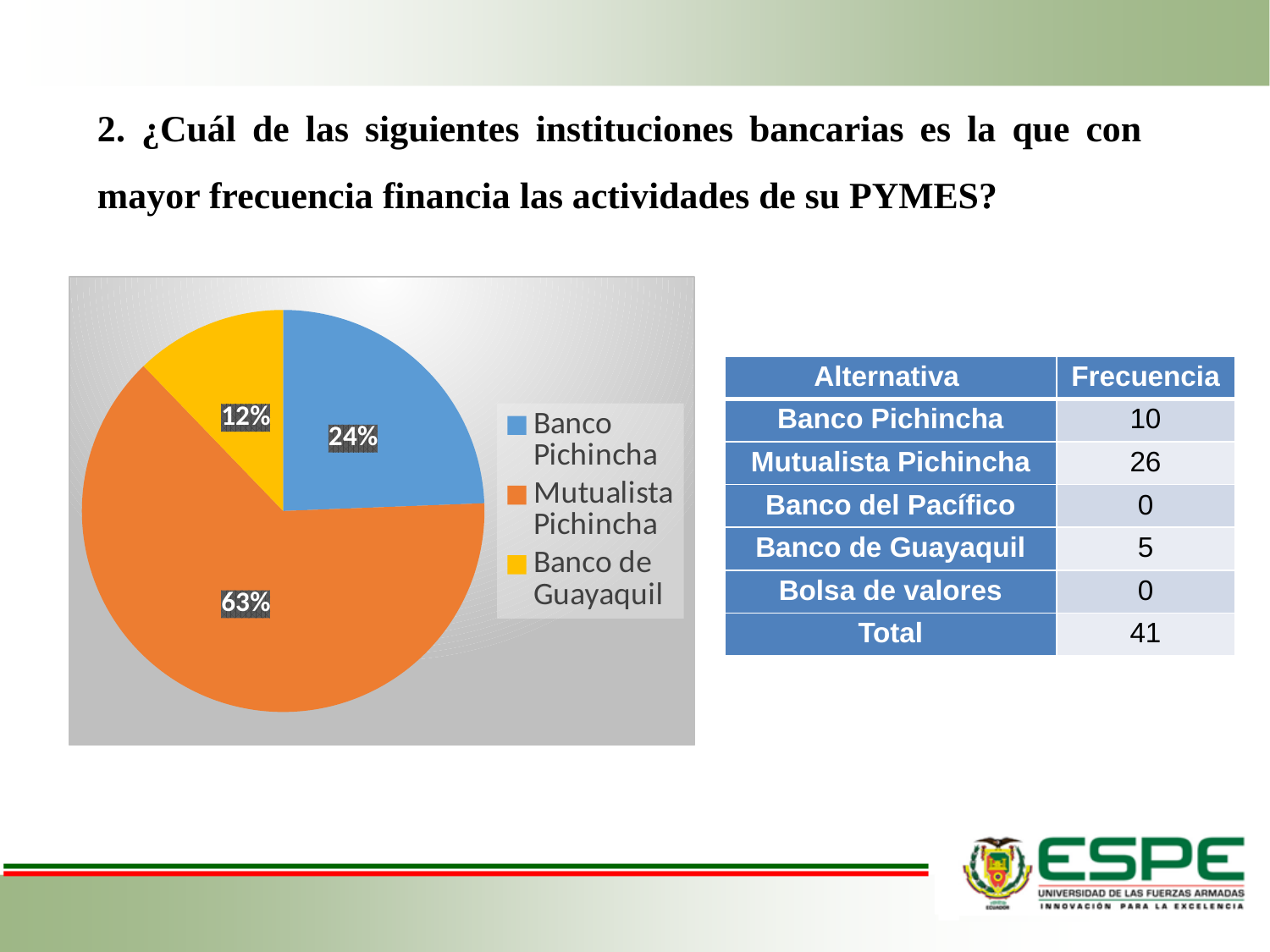
How many entries does the legend list? 3 Which slice is larger, Banco Pichincha or Banco de Guayaquil? Banco Pichincha What share of the pie does Banco de Guayaquil have? 12% What share of the pie does Mutualista Pichincha have? 63% Which category has the smallest slice of the pie? Banco de Guayaquil What share of the pie does Banco Pichincha have? 24% Which category has the largest slice of the pie? Mutualista Pichincha What kind of chart is shown on the slide? pie chart What colour is the Banco de Guayaquil slice? yellow What is the difference in percentage points between the Mutualista Pichincha slice and the Banco Pichincha slice? 39% What colour is the Mutualista Pichincha slice? orange How many slices does the pie chart have? 3